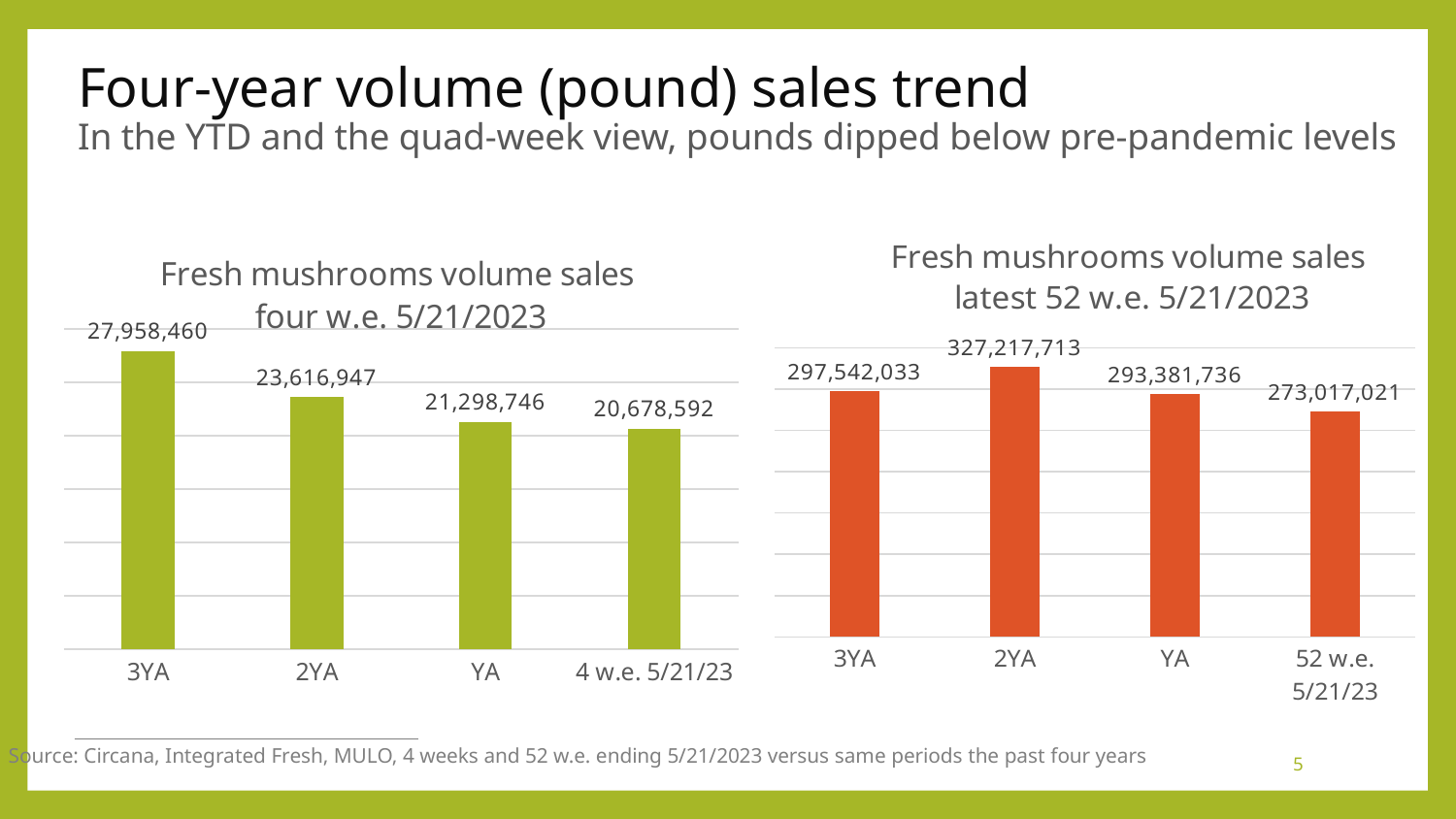
In the 'Fresh mushrooms volume sales latest 52 w.e. 5/21/2023' chart, what is the value for 2YA? 327,217,713 How many categories are shown in the 'Fresh mushrooms volume sales four w.e. 5/21/2023' chart? 4 What kind of chart is the 'Fresh mushrooms volume sales latest 52 w.e. 5/21/2023' chart? Bar chart In the 'Fresh mushrooms volume sales latest 52 w.e. 5/21/2023' chart, which category has the highest value? 2YA In the 'Fresh mushrooms volume sales four w.e. 5/21/2023' chart, what is the difference between the 3YA value and the 4 w.e. 5/21/23 value? 7,279,868 In the 'Fresh mushrooms volume sales four w.e. 5/21/2023' chart, what is the value for 3YA? 27,958,460 In the 'Fresh mushrooms volume sales latest 52 w.e. 5/21/2023' chart, which is larger, the value for 3YA or the value for YA? 3YA In the 'Fresh mushrooms volume sales latest 52 w.e. 5/21/2023' chart, what is the value for 52 w.e. 5/21/23? 273,017,021 In the 'Fresh mushrooms volume sales four w.e. 5/21/2023' chart, what is the value for 4 w.e. 5/21/23? 20,678,592 In the 'Fresh mushrooms volume sales four w.e. 5/21/2023' chart, do the values rise or fall from 3YA to 4 w.e. 5/21/23? Fall In the 'Fresh mushrooms volume sales latest 52 w.e. 5/21/2023' chart, what is the difference between the 2YA value and the 52 w.e. 5/21/23 value? 54,200,692 In the 'Fresh mushrooms volume sales four w.e. 5/21/2023' chart, which category has the lowest value? 4 w.e. 5/21/23